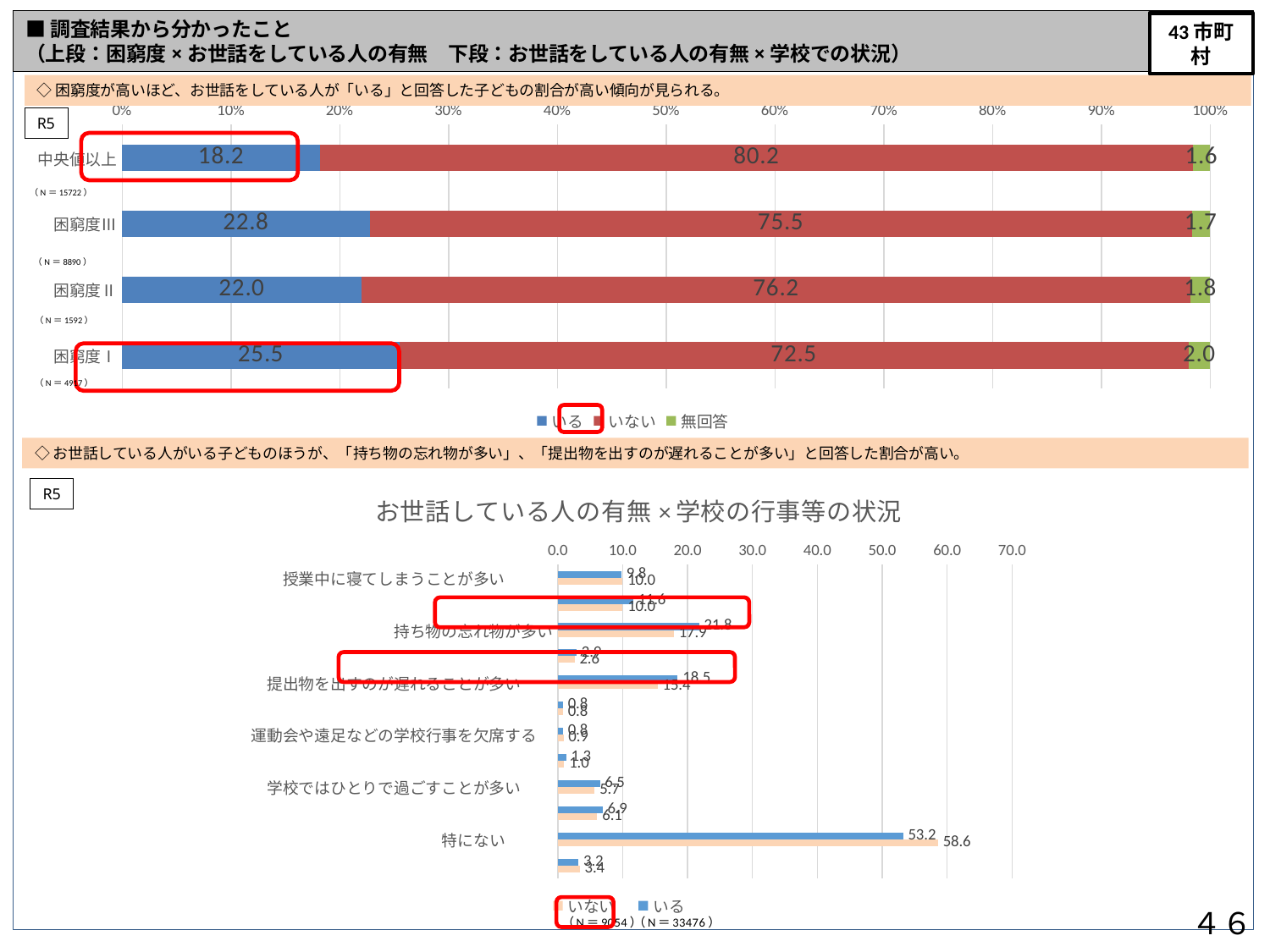
In the top chart, how many series does the legend list? 3 In the top chart, what is the value for いない for 中央値以上? 80.2 What kind of chart is the top chart? Stacked bar chart In the bottom chart titled お世話している人の有無×学校の行事等の状況, which is larger for 提出物を出すのが遅れることが多い: いる or いない? いる In the top chart, what is the value for いる for 困窮度Ⅰ? 25.5 In the top chart, how many categories are shown on the vertical axis? 4 In the bottom chart titled お世話している人の有無×学校の行事等の状況, what is the value for いる for 特にない? 53.2 In the top chart, which is larger: the いない value for 困窮度Ⅲ or for 困窮度Ⅱ? 困窮度Ⅱ In the bottom chart titled お世話している人の有無×学校の行事等の状況, what is the value for いない for 持ち物の忘れ物が多い? 17.9 In the top chart, what is the difference between the いる values for 困窮度Ⅰ and 中央値以上? 7.3 In the top chart, which category has the lowest value for いる? 中央値以上 In the top chart, which category has the highest value for いる? 困窮度Ⅰ